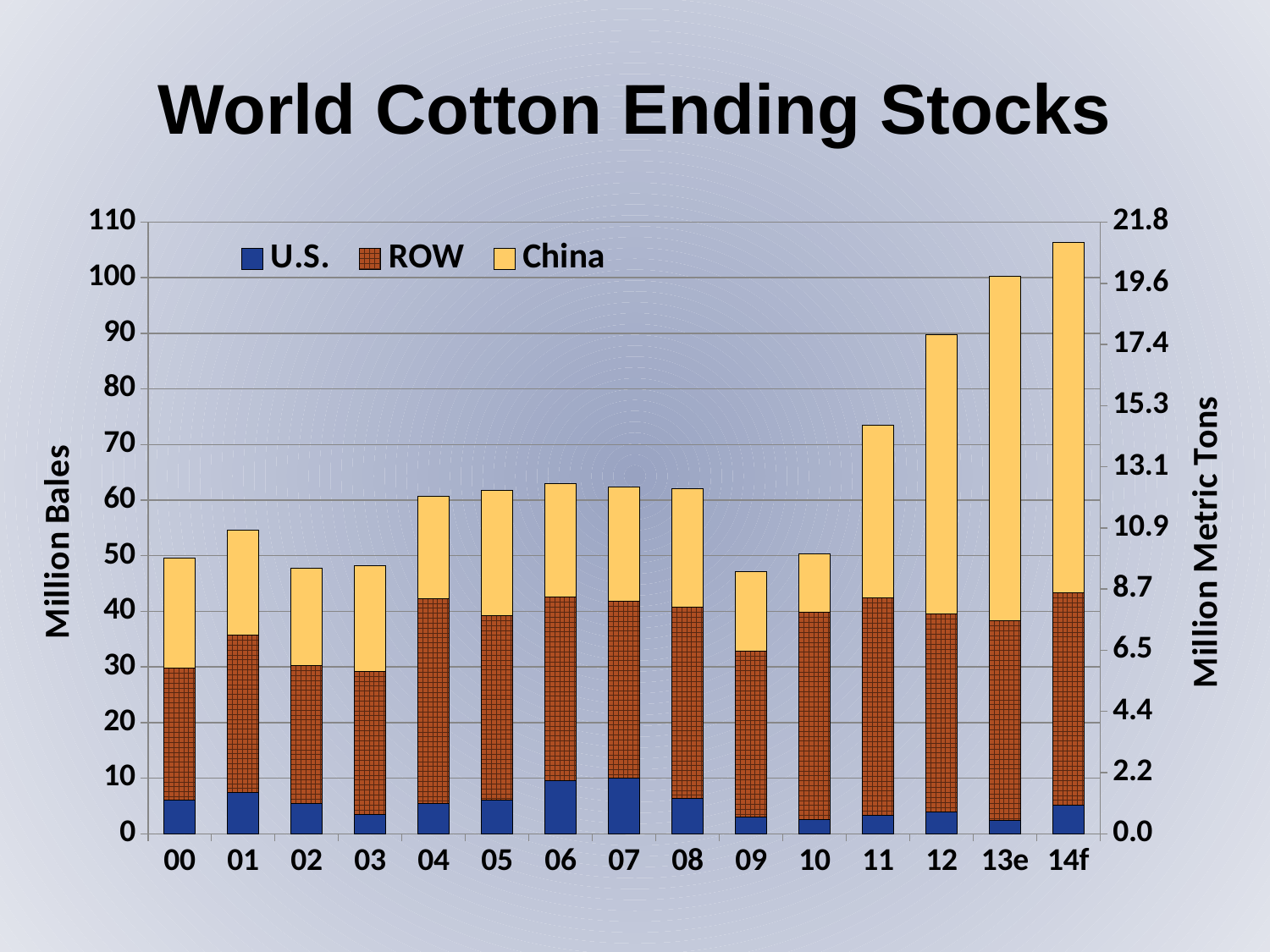
How many series does the legend list? 3 Is the total ending stocks for 09 greater or less than 50 million bales? less Which year has the larger total ending stocks, 00 or 01? 01 Do total ending stocks rise or fall from 10 to 14f? rise How many years (categories) are shown along the x axis? 15 What is the label on the left vertical axis? Million Bales Which year has the larger total ending stocks, 11 or 12? 12 Is the total ending stocks for 13e greater or less than 90 million bales? greater What kind of chart is shown on the slide? Stacked bar chart Is the total ending stocks for 12 greater or less than 80 million bales? greater Which year has the highest total ending stocks? 14f